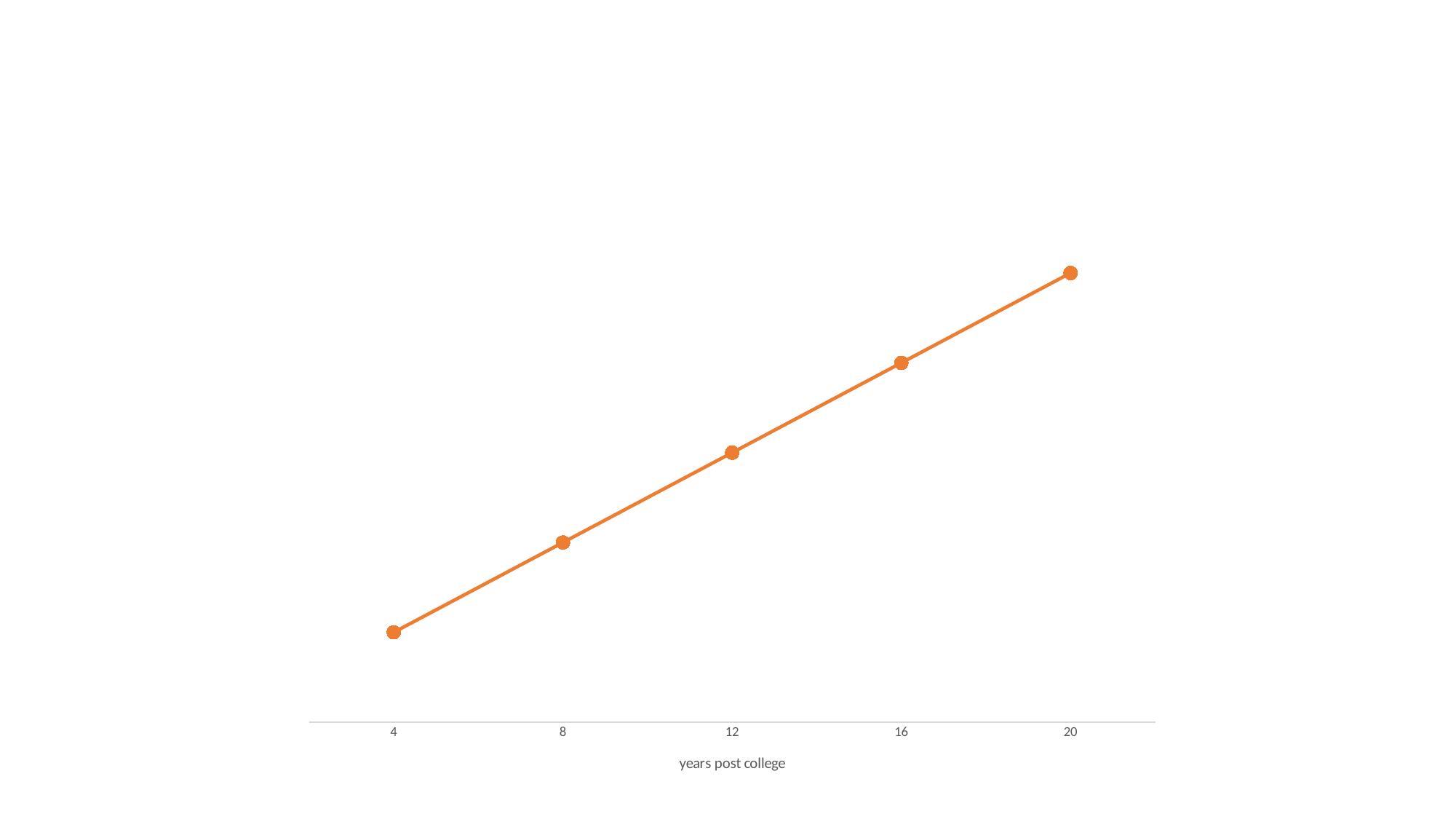
How many data points are plotted on the line? 5 What colour is the plotted line? orange Do the plotted values rise or fall as years post college increase from 4 to 20? rise What is the title of the x axis? years post college Which has the larger plotted value: 12 years post college or 4 years post college? 12 years post college At which value of years post college is the plotted value highest? 20 What kind of chart is shown on the slide? line chart Which has the larger plotted value: 8 years post college or 16 years post college? 16 years post college At which value of years post college is the plotted value lowest? 4 What are the x-axis tick labels shown on the chart? 4, 8, 12, 16, 20